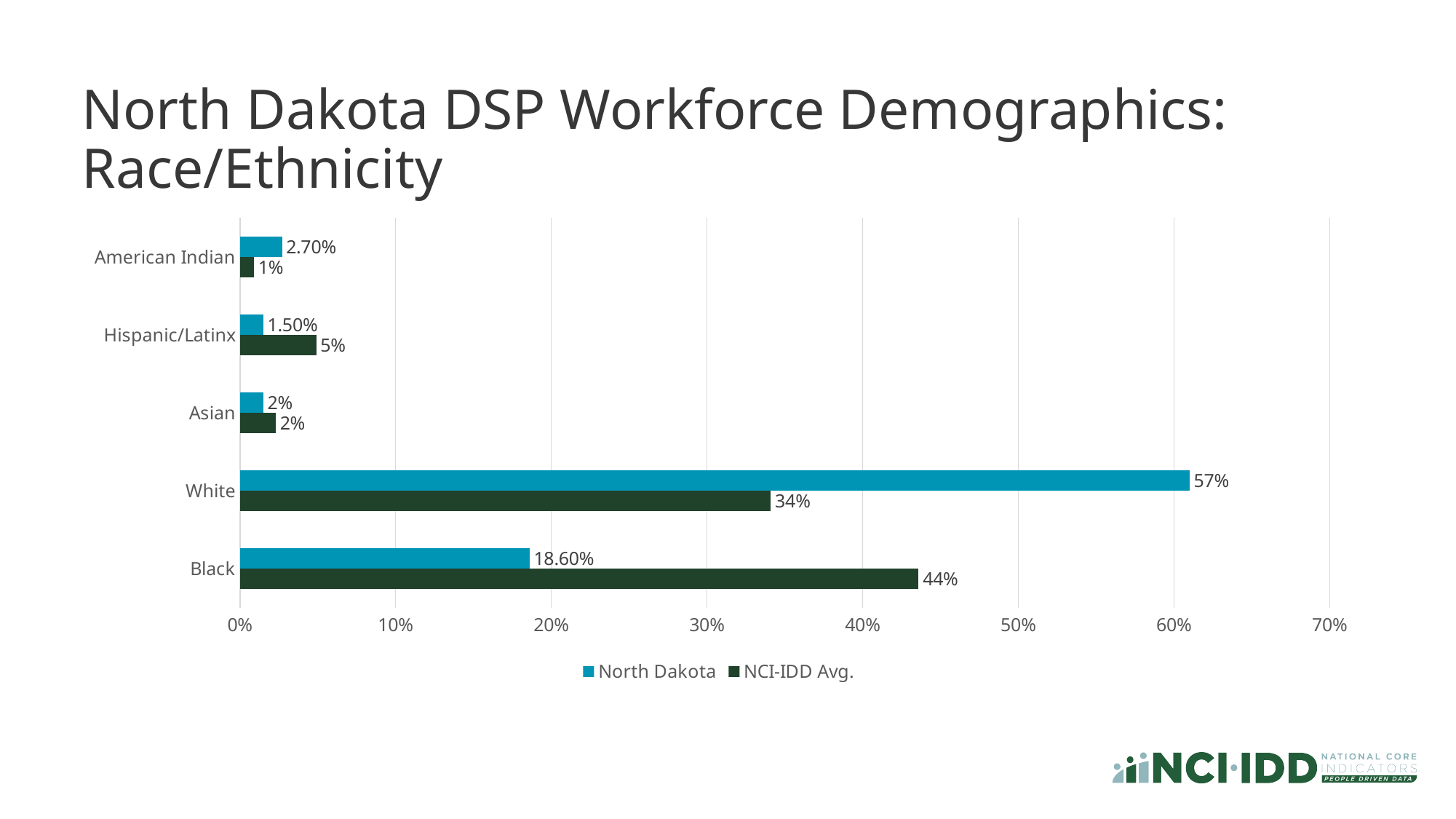
Which category has the highest North Dakota value? White Is the North Dakota value for Black greater or less than 20%? less Which category has the highest NCI-IDD Avg. value? Black What is the NCI-IDD Avg. value for Black? 44% How many series does the legend list? 2 What is the North Dakota value for White? 57% How many race/ethnicity categories are shown on the chart? 5 Which is larger for Black: the North Dakota value or the NCI-IDD Avg. value? NCI-IDD Avg. What is the North Dakota value for Hispanic/Latinx? 1.50% What is the NCI-IDD Avg. value for American Indian? 1% What is the difference between the North Dakota and NCI-IDD Avg. values for White? 23% What kind of chart is shown on the slide? Bar chart